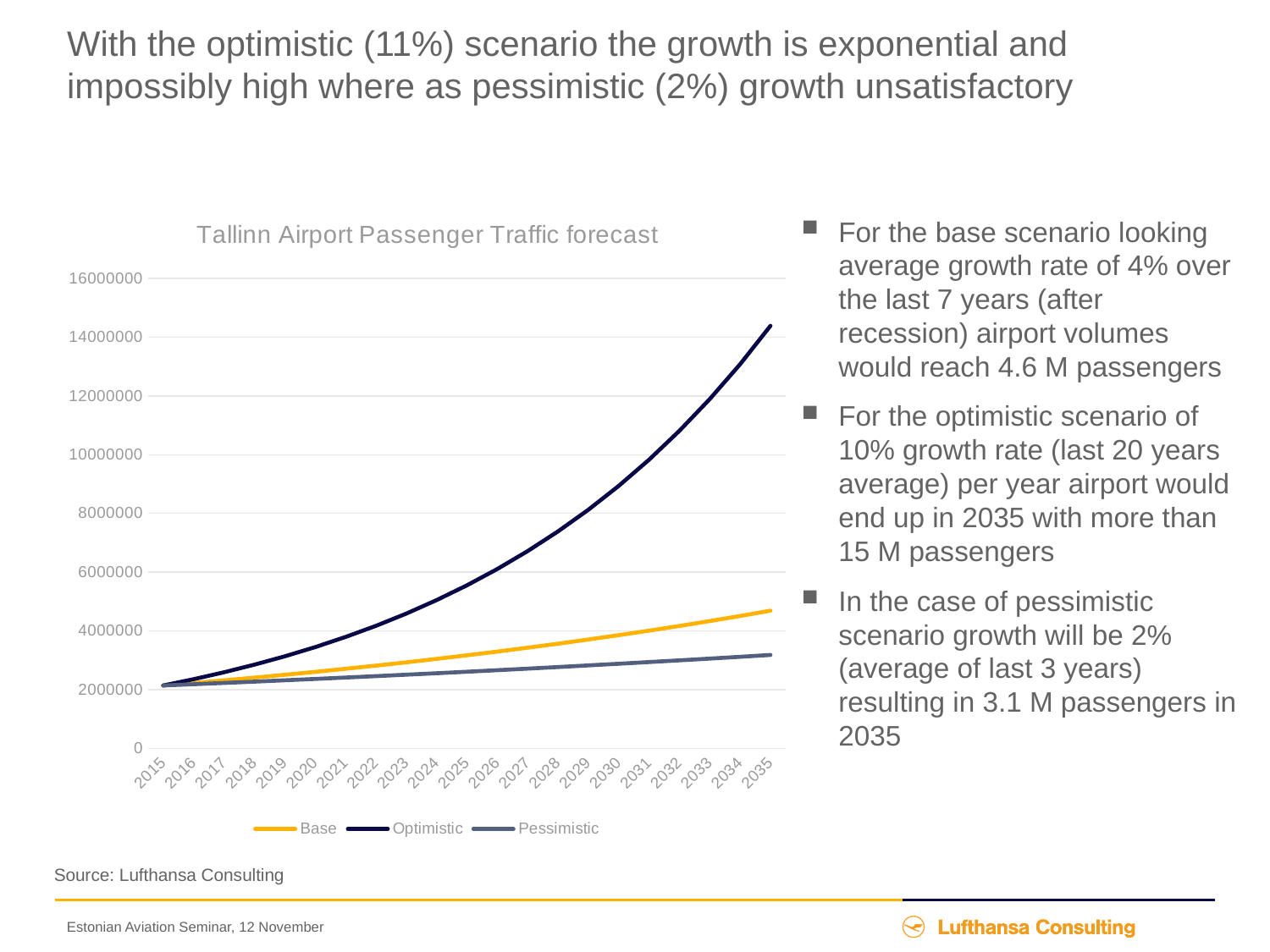
Is the value for the Pessimistic series in 2035 greater or less than 4000000? less In 2035, which is larger: the Base series or the Pessimistic series? Base How many series does the chart legend list? 3 What is the title of the chart? Tallinn Airport Passenger Traffic forecast Which series has the lowest value in 2035? Pessimistic What kind of chart is shown on the slide? line chart Is the value for the Optimistic series in 2035 greater or less than 12000000? greater Which series are listed in the chart legend? Base, Optimistic, Pessimistic Does the Optimistic series rise or fall from 2015 to 2035? rise Is the value for the Optimistic series in 2030 greater or less than 8000000? greater How many years are shown on the x axis of the chart? 21 Which series has the highest value in 2035? Optimistic